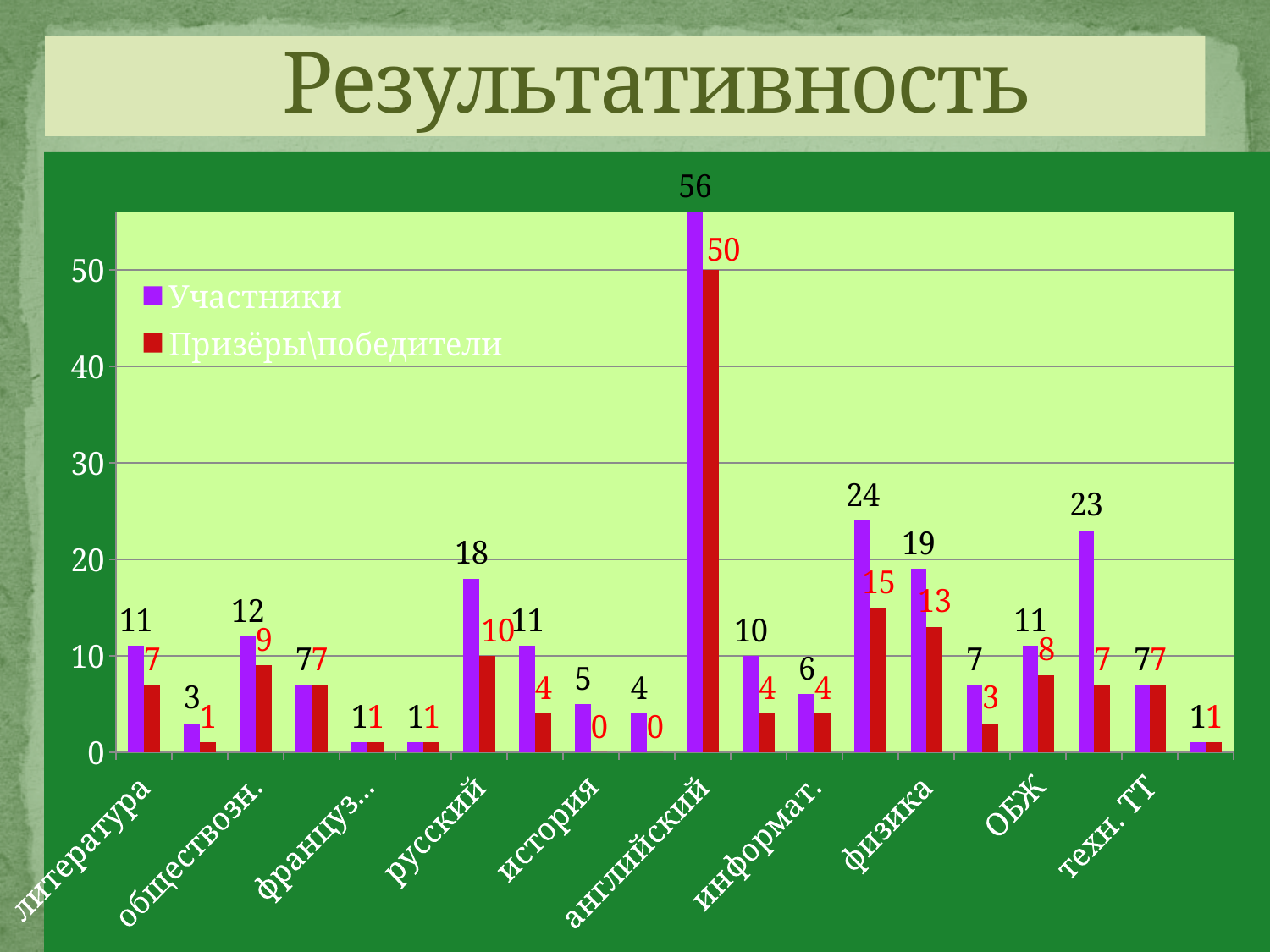
What is the value of Призёры\победители for английский? 50 What is the difference between Участники and Призёры\победители for английский? 6 What is the value of Призёры\победители for история? 0 How many series does the legend list? 2 Which is larger, the Участники value for физика or for ОБЖ? физика What is the value of Призёры\победители for физика? 13 Which category has the highest value of Участники? английский What is the value of Участники for английский? 56 What is the title of the slide? Результативность What is the value of Участники for русский? 18 Is the value of Участники for английский greater or less than 50? greater What kind of chart is shown on the slide? bar chart